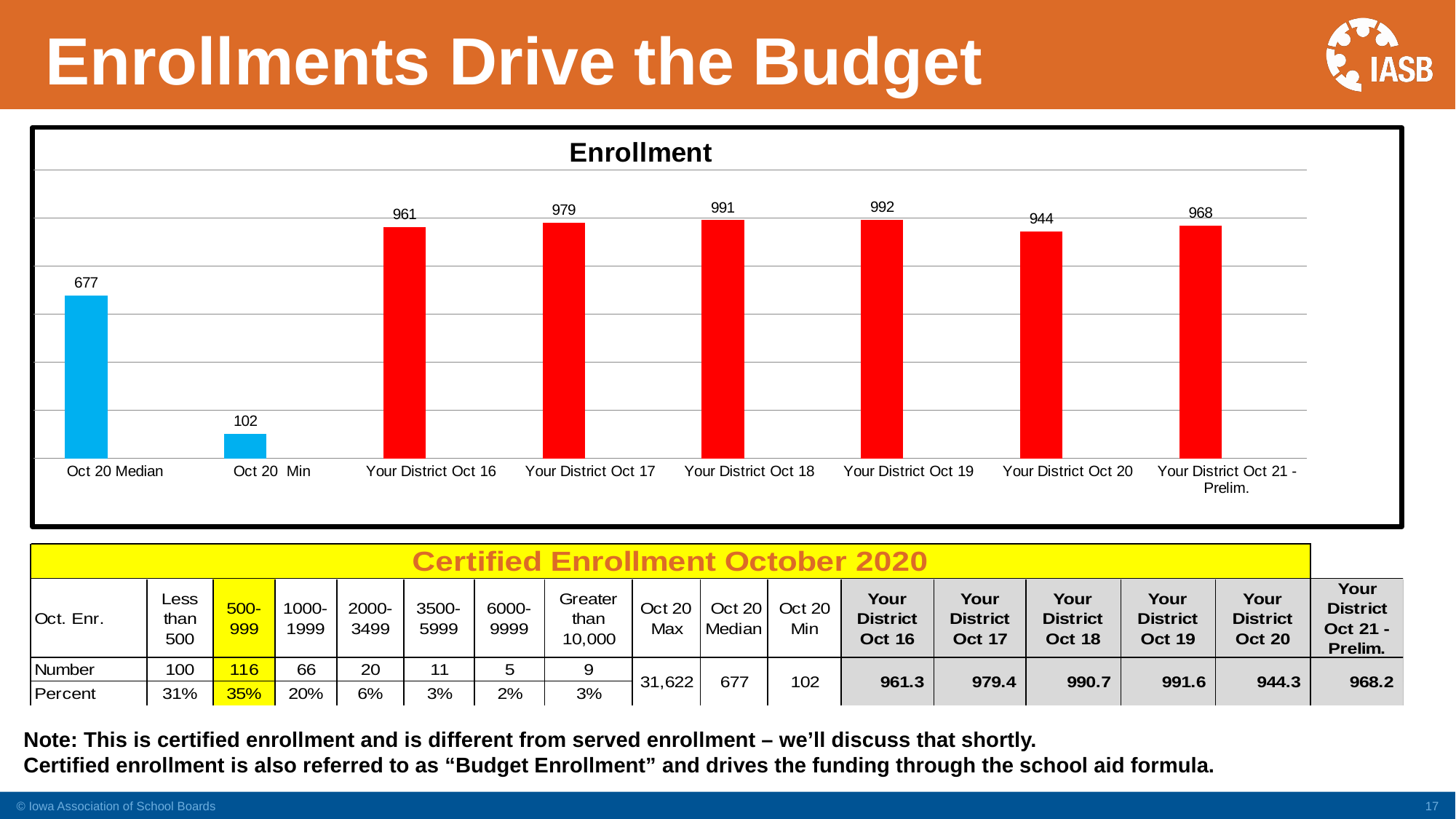
What is the value shown for Your District Oct 21 - Prelim. in the Enrollment chart? 968 What colour are the Oct 20 Median and Oct 20 Min bars in the Enrollment chart? Blue Which category has the lowest value in the Enrollment chart? Oct 20 Min What is the value of the Oct 20 Median bar in the Enrollment chart? 677 What type of chart is used to show Enrollment on this slide? Bar chart What is the value shown for Your District Oct 18 in the Enrollment chart? 991 How much higher is the Your District Oct 16 value than the Oct 20 Median value in the Enrollment chart? 284 Do the Your District values rise or fall from Oct 16 to Oct 19 in the Enrollment chart? Rise Which category has the highest value in the Enrollment chart? Your District Oct 19 What is the difference between the Your District Oct 19 and Your District Oct 20 values in the Enrollment chart? 48 Which is larger in the Enrollment chart: Your District Oct 17 or Your District Oct 21 - Prelim.? Your District Oct 17 How many bars are shown in the Enrollment chart? 8